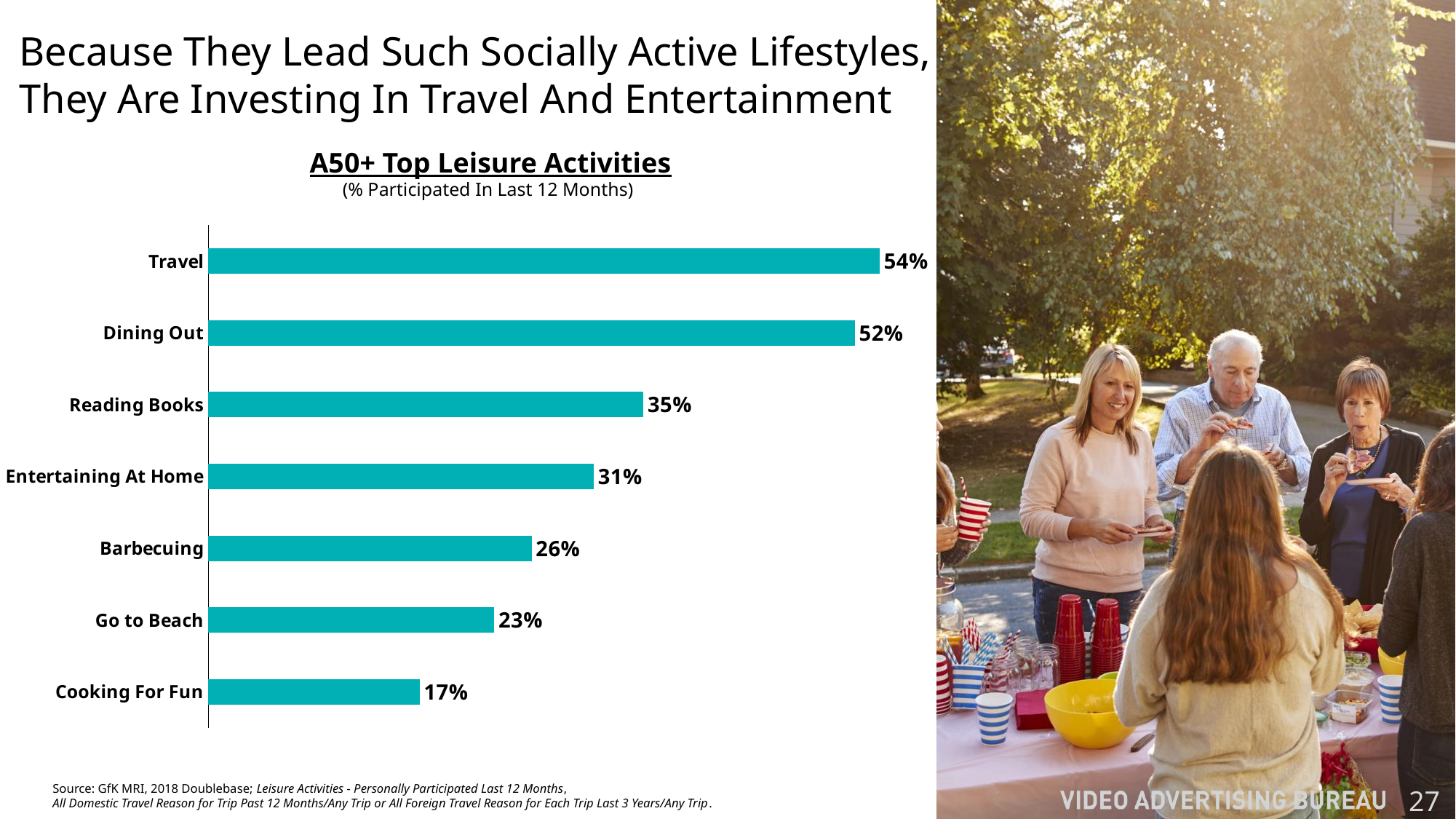
What percentage of A50+ participated in Travel in the last 12 months? 54% Which has a larger value, Reading Books or Barbecuing? Reading Books What is the difference between the values for Entertaining At Home and Barbecuing? 5% What is the title of the chart? A50+ Top Leisure Activities Which leisure activity has the highest participation? Travel How many leisure activities are shown in the chart? 7 Which leisure activity has the lowest participation? Cooking For Fun What is the difference between the values for Travel and Dining Out? 2% What colour are the bars in the chart? Teal What is the value shown for Reading Books? 35% What is the value shown for Go to Beach? 23% What kind of chart is used on this slide? Bar chart